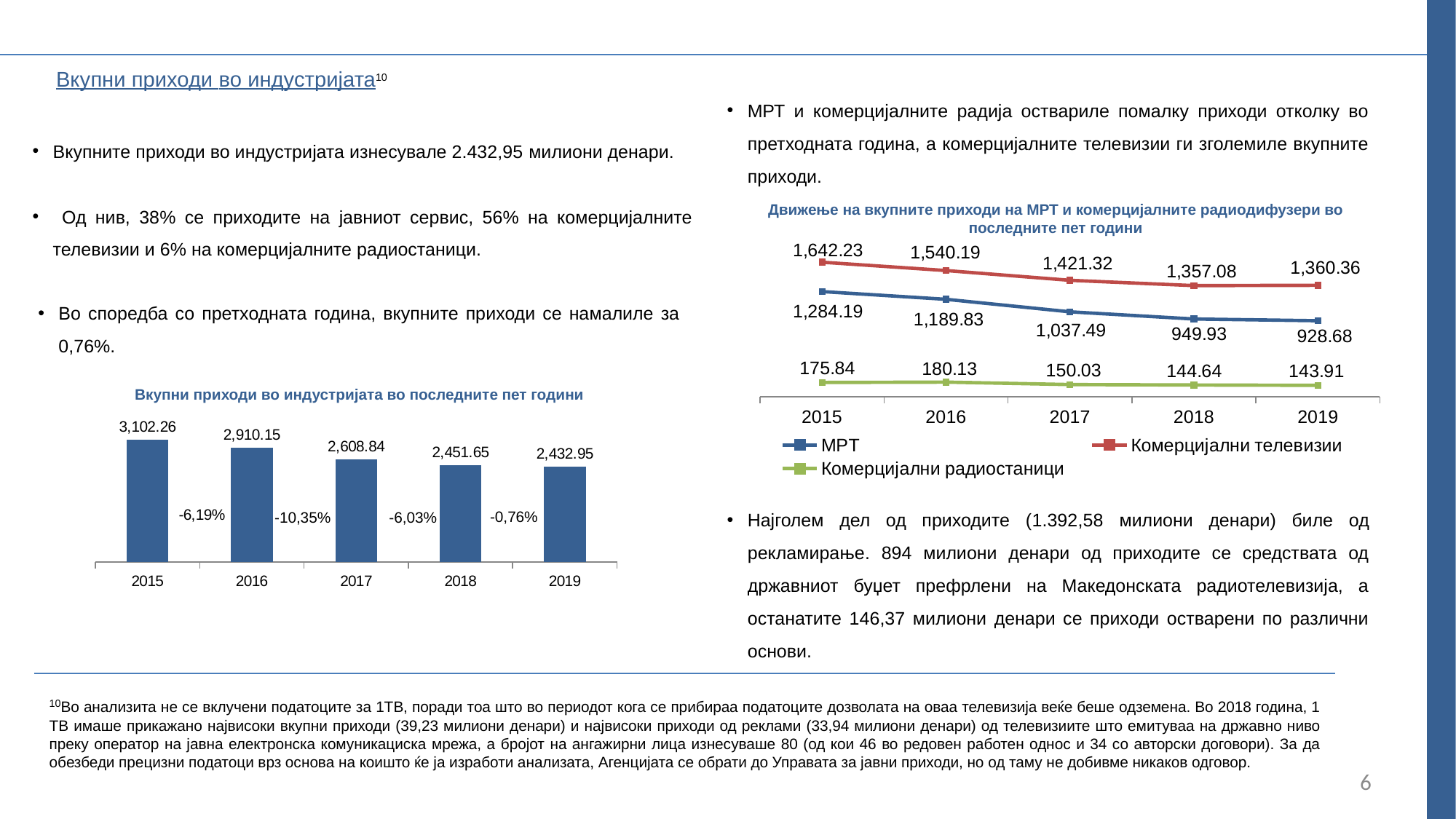
In the bar chart 'Вкупни приходи во индустријата во последните пет години', what is the value for 2015? 3,102.26 What kind of chart is 'Вкупни приходи во индустријата во последните пет години'? bar chart In the bar chart 'Вкупни приходи во индустријата во последните пет години', what is the difference between the 2016 and 2017 values? 301.31 In the bar chart 'Вкупни приходи во индустријата во последните пет години', do the values rise or fall from 2015 to 2019? fall In the line chart 'Движење на вкупните приходи на МРТ и комерцијалните радиодифузери во последните пет години', which series has the highest value in 2019? Комерцијални телевизии In the line chart 'Движење на вкупните приходи на МРТ и комерцијалните радиодифузери во последните пет години', how many series does the legend list? 3 In the line chart 'Движење на вкупните приходи на МРТ и комерцијалните радиодифузери во последните пет години', what is the value for Комерцијални радиостаници in 2016? 180.13 In the line chart 'Движење на вкупните приходи на МРТ и комерцијалните радиодифузери во последните пет години', what is the value for МРТ in 2017? 1,037.49 In the bar chart 'Вкупни приходи во индустријата во последните пет години', what percentage change is shown between 2016 and 2017? -10,35% In the bar chart 'Вкупни приходи во индустријата во последните пет години', which year has the lowest value? 2019 In the line chart 'Движење на вкупните приходи на МРТ и комерцијалните радиодифузери во последните пет години', what is the difference between Комерцијални телевизии and МРТ in 2015? 358.04 In the line chart 'Движење на вкупните приходи на МРТ и комерцијалните радиодифузери во последните пет години', which is larger: Комерцијални радиостаници in 2015 or in 2018? 2015